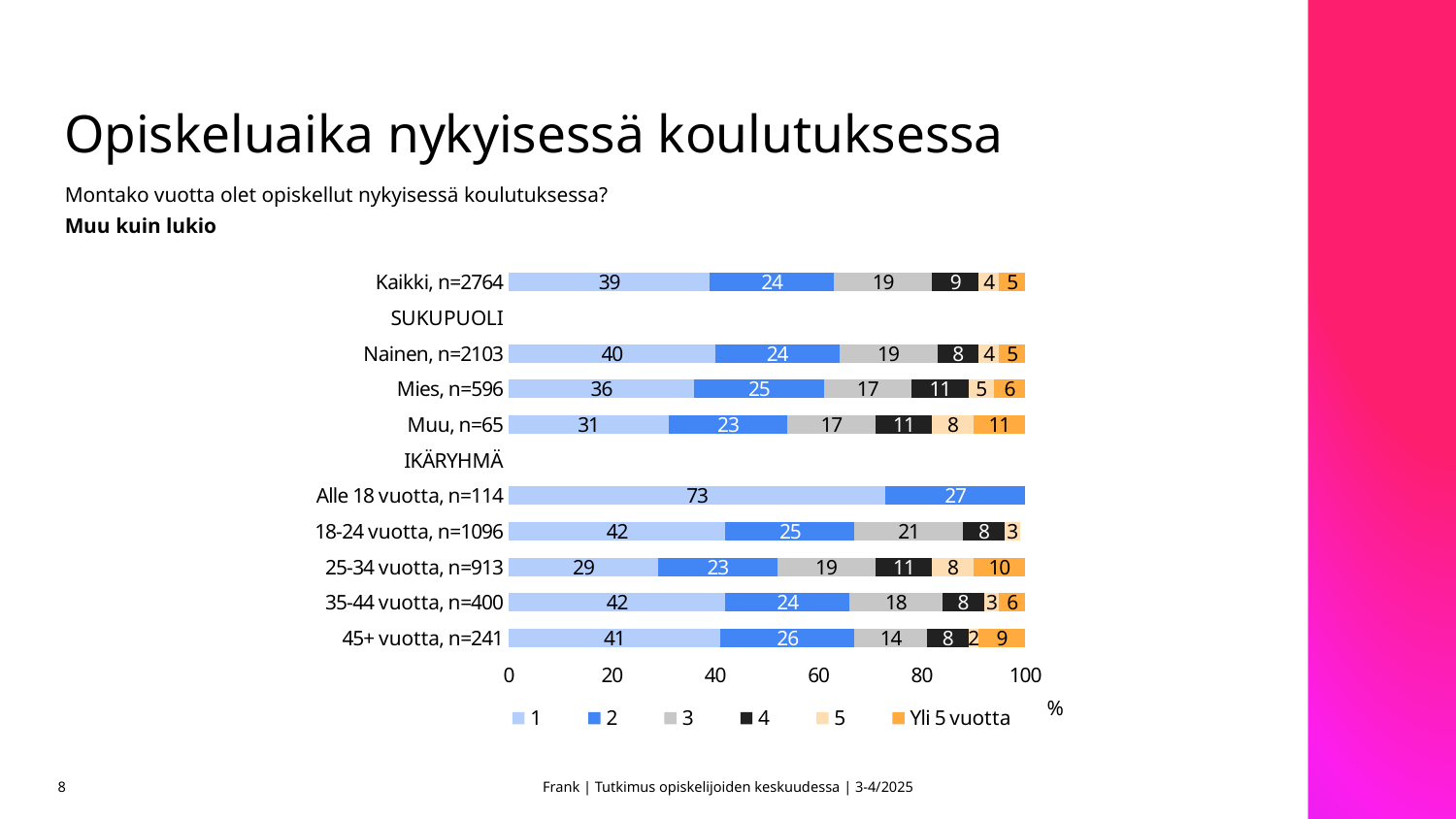
What kind of chart is shown on the slide? Stacked bar chart Which group has the lowest value for series "1"? 25-34 vuotta, n=913 What is the difference between the series "1" values for "Nainen, n=2103" and "Mies, n=596"? 4 Which is larger: the "Yli 5 vuotta" value for "25-34 vuotta, n=913" or for "45+ vuotta, n=241"? 25-34 vuotta, n=913 What is the value of "Yli 5 vuotta" for "Muu, n=65"? 11 Which group has the highest value for series "1"? Alle 18 vuotta, n=114 What is the last entry in the chart legend? Yli 5 vuotta What is the value of series "2" for "Mies, n=596"? 25 How many series does the legend list? 6 What is the total of the stacked bar for "Kaikki, n=2764"? 100 What is the value of series "1" for "Kaikki, n=2764"? 39 How many data bars (respondent groups) are plotted in the chart? 9